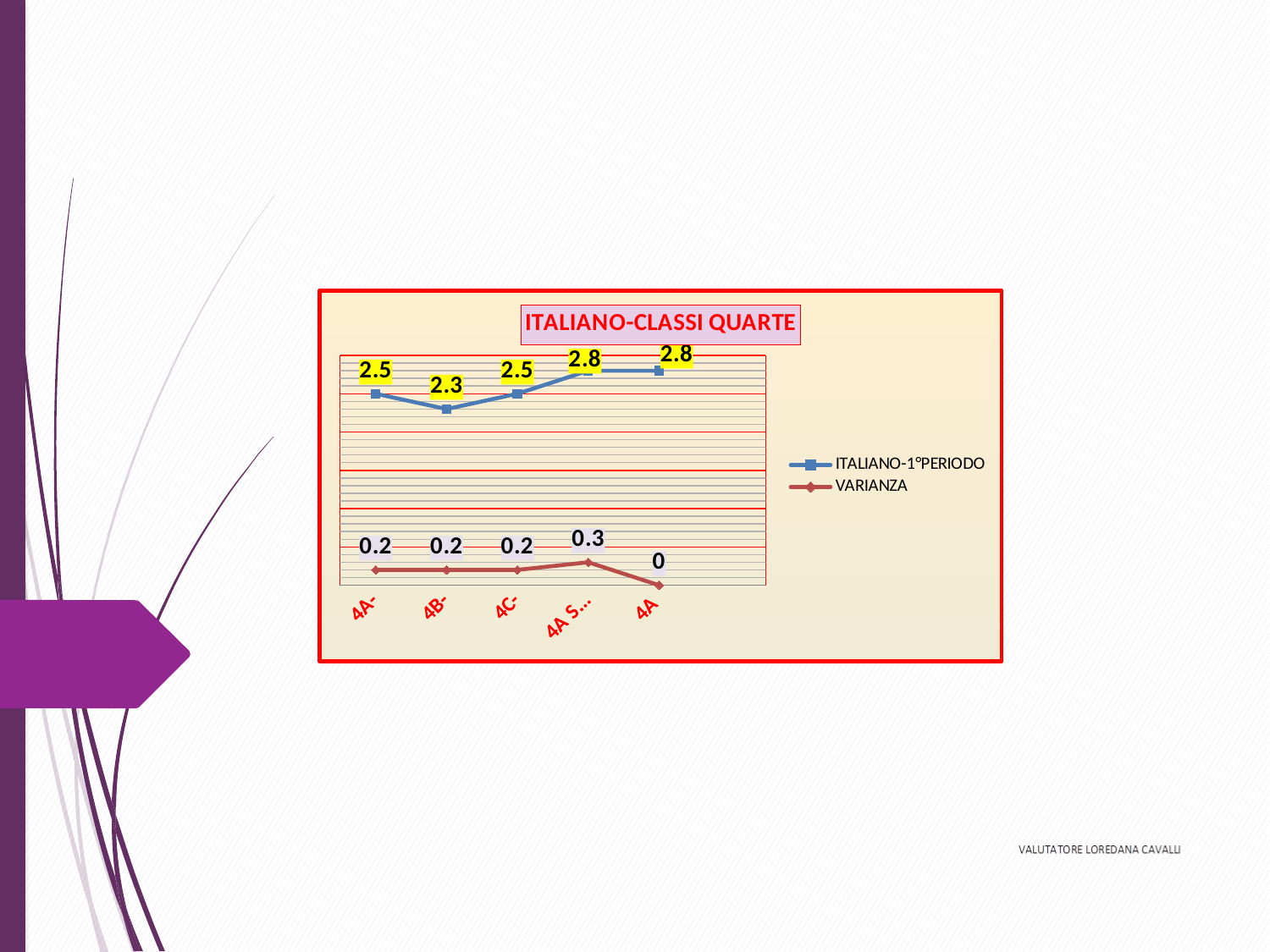
What is the VARIANZA value for 4A? 0 Which category has the lowest VARIANZA value? 4A What kind of chart is shown? line chart What is the VARIANZA value for 4C-? 0.2 What is the title of the chart? ITALIANO-CLASSI QUARTE How many categories are shown on the x axis? 5 Which category has the lowest ITALIANO-1°PERIODO value? 4B- Which has the larger ITALIANO-1°PERIODO value, 4A- or 4B-? 4A- How many series does the legend list? 2 What is the ITALIANO-1°PERIODO value for 4B-? 2.3 What is the ITALIANO-1°PERIODO value for 4A-? 2.5 What is the difference between the ITALIANO-1°PERIODO values for 4A and 4B-? 0.5